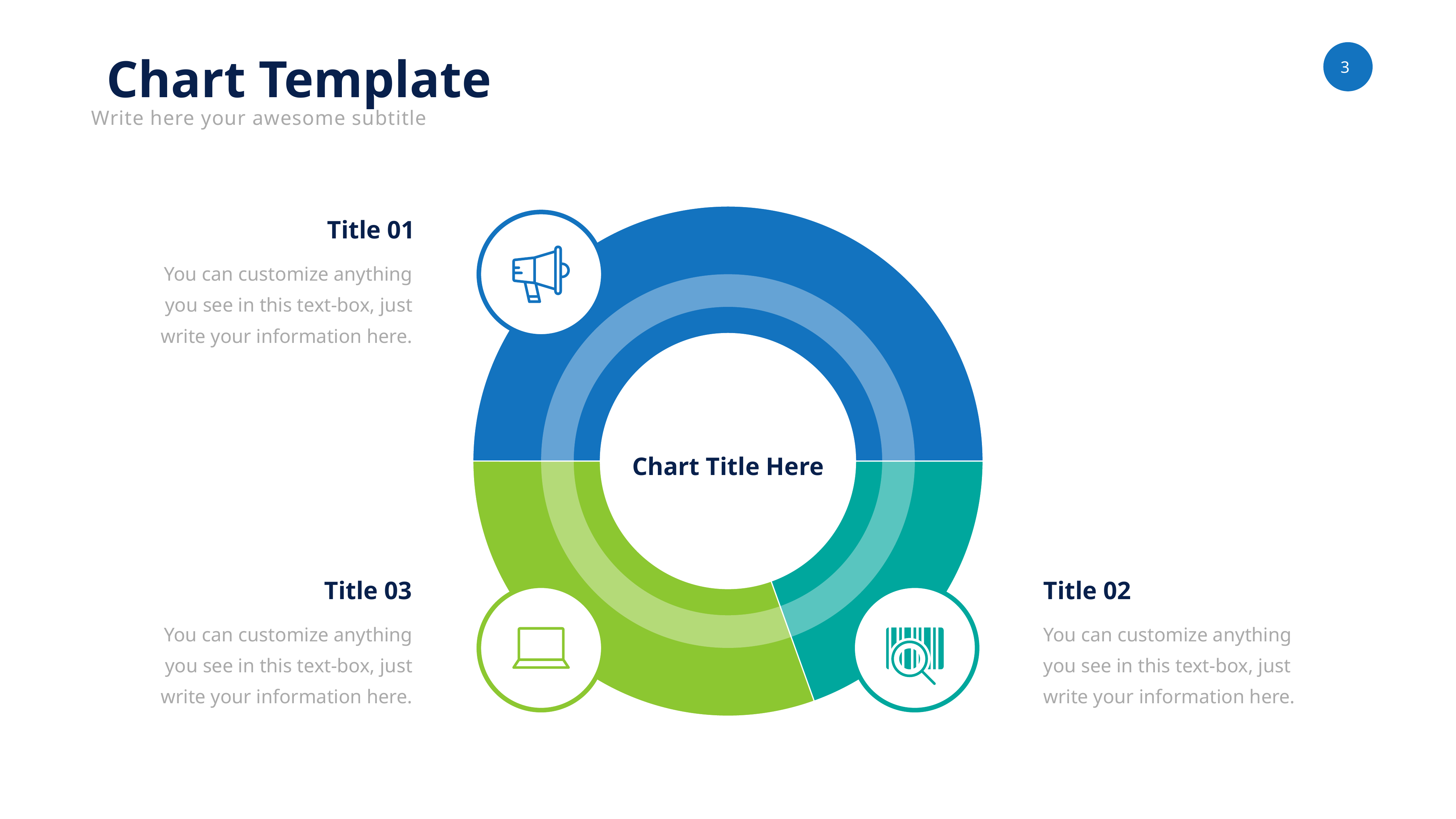
Which is larger in the doughnut chart, the blue segment (Title 01) or the teal segment (Title 02)? The blue segment (Title 01) Which segment of the doughnut chart is the largest? The blue segment (Title 01) What kind of chart is shown on the slide? Doughnut chart Which is larger in the doughnut chart, the green segment (Title 03) or the teal segment (Title 02)? The green segment (Title 03) What text appears in the centre of the doughnut chart? Chart Title Here How many segments does the doughnut chart have? 3 What colour is the segment labelled Title 03? Green Which segment of the doughnut chart is the smallest? The teal segment (Title 02)